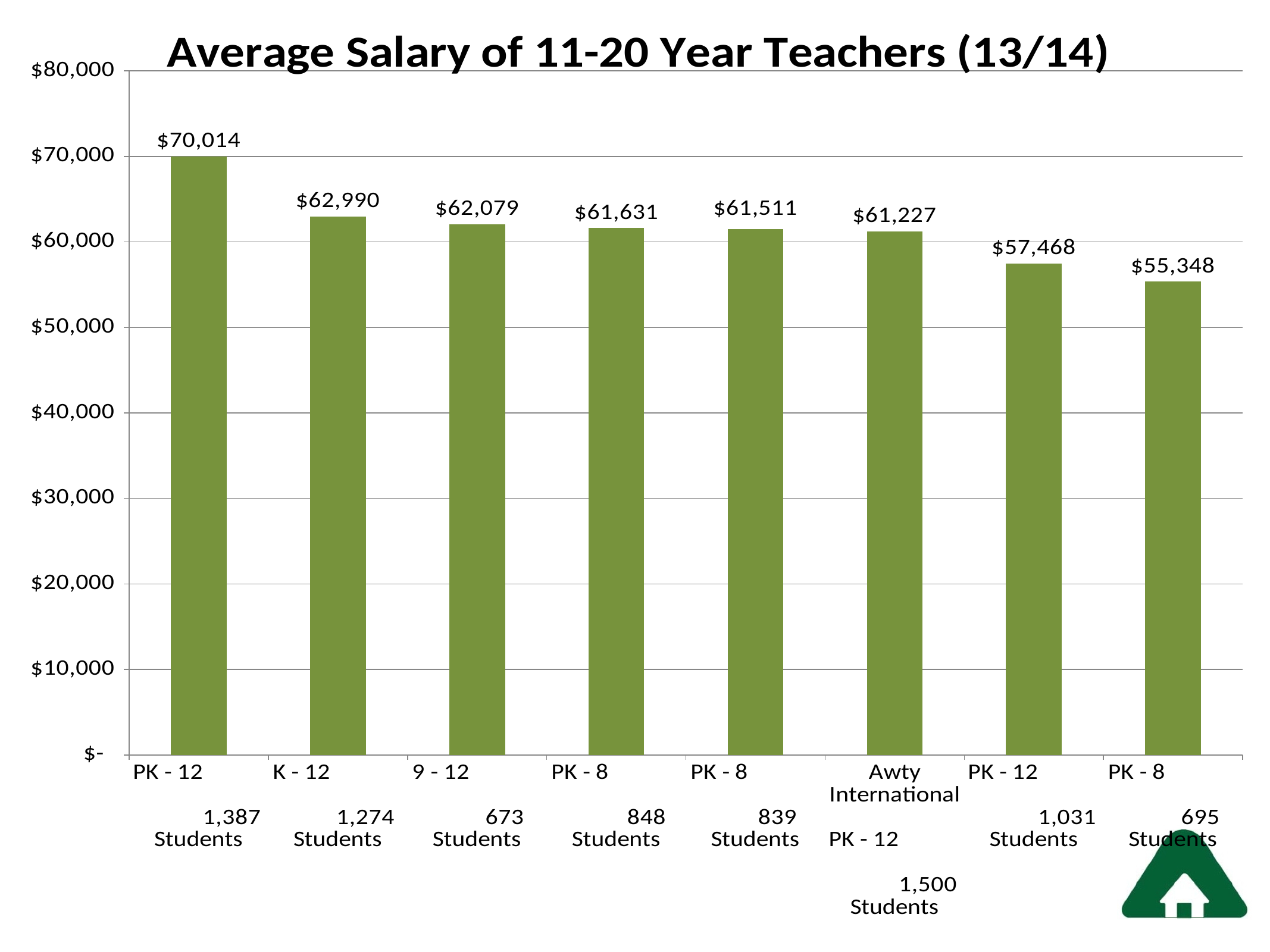
Which school has the lowest average salary for 11-20 year teachers? PK - 8 (695 Students) Which school has the highest average salary for 11-20 year teachers? PK - 12 (1,387 Students) Is the average salary for the PK - 12 school with 1,031 students greater or less than $60,000? less What is the title of the chart? Average Salary of 11-20 Year Teachers (13/14) What is the difference between the highest ($70,014) and lowest ($55,348) average salaries shown? $14,666 What type of chart is used on this slide? bar chart What is the average salary for the K - 12 school with 1,274 students? $62,990 What is the average salary shown for Awty International (PK - 12, 1,500 students)? $61,227 What is the difference between the highest average salary ($70,014) and the K - 12 school's average salary ($62,990)? $7,024 How many schools (bars) are shown in the chart? 8 What is the average salary for the 9 - 12 school with 673 students? $62,079 Which is larger: the average salary for the PK - 8 school with 848 students or the PK - 8 school with 839 students? PK - 8 with 848 students